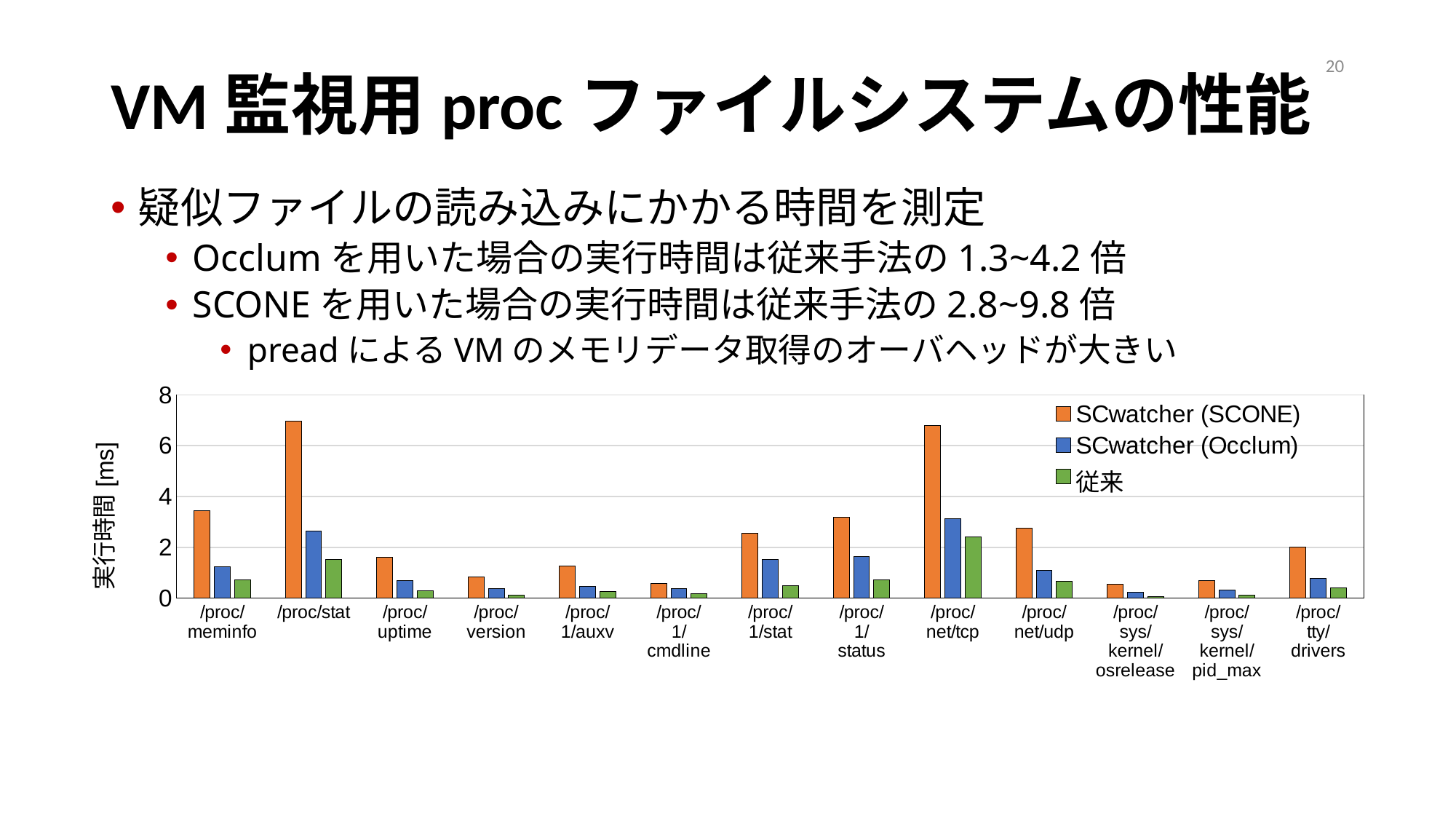
Is the SCwatcher (SCONE) value for /proc/uptime greater or less than 2? less What is the label of the chart's y axis? 実行時間 [ms] How many proc file categories are shown on the x axis of the chart? 13 Is the SCwatcher (Occlum) value for /proc/net/tcp greater or less than 2? greater What kind of chart is shown on the slide? bar chart How many series does the chart legend list? 3 Which category has the highest 従来 value? /proc/net/tcp Is the 従来 value for /proc/stat greater or less than 2? less For /proc/meminfo, which is larger: the SCwatcher (SCONE) value or the SCwatcher (Occlum) value? SCwatcher (SCONE) Which category has the highest SCwatcher (Occlum) value? /proc/net/tcp